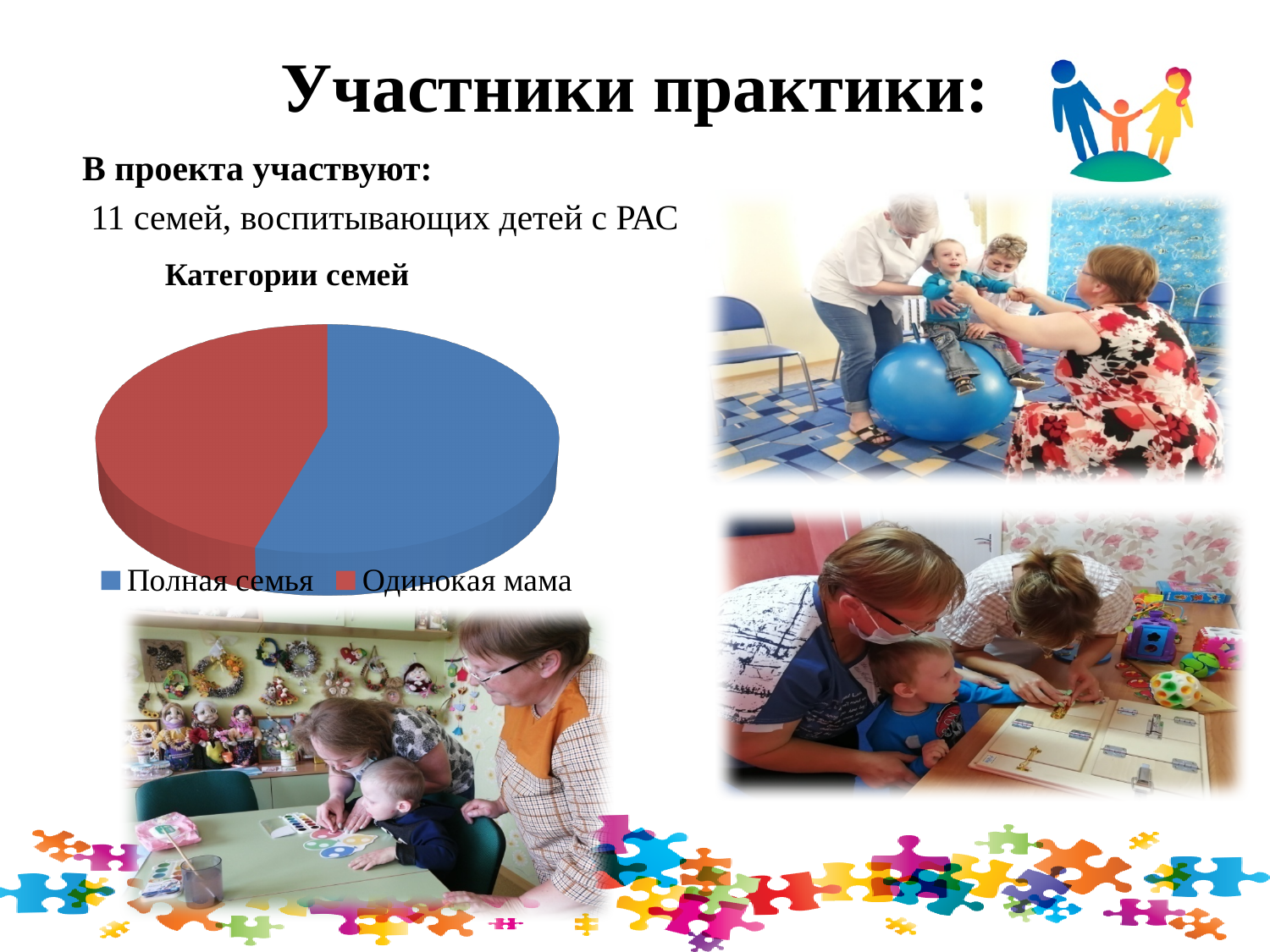
In the "Категории семей" pie chart, which slice is larger: "Полная семья" or "Одинокая мама"? Полная семья How many entries does the legend of the "Категории семей" chart list? 2 Which category takes the smaller share of the "Категории семей" pie chart? Одинокая мама How many categories does the "Категории семей" pie chart have? 2 What is the title of the pie chart on the slide? Категории семей Which colour represents "Одинокая мама" in the pie chart? red What kind of chart is shown under the heading "Категории семей"? pie chart Which category takes the larger share of the "Категории семей" pie chart? Полная семья